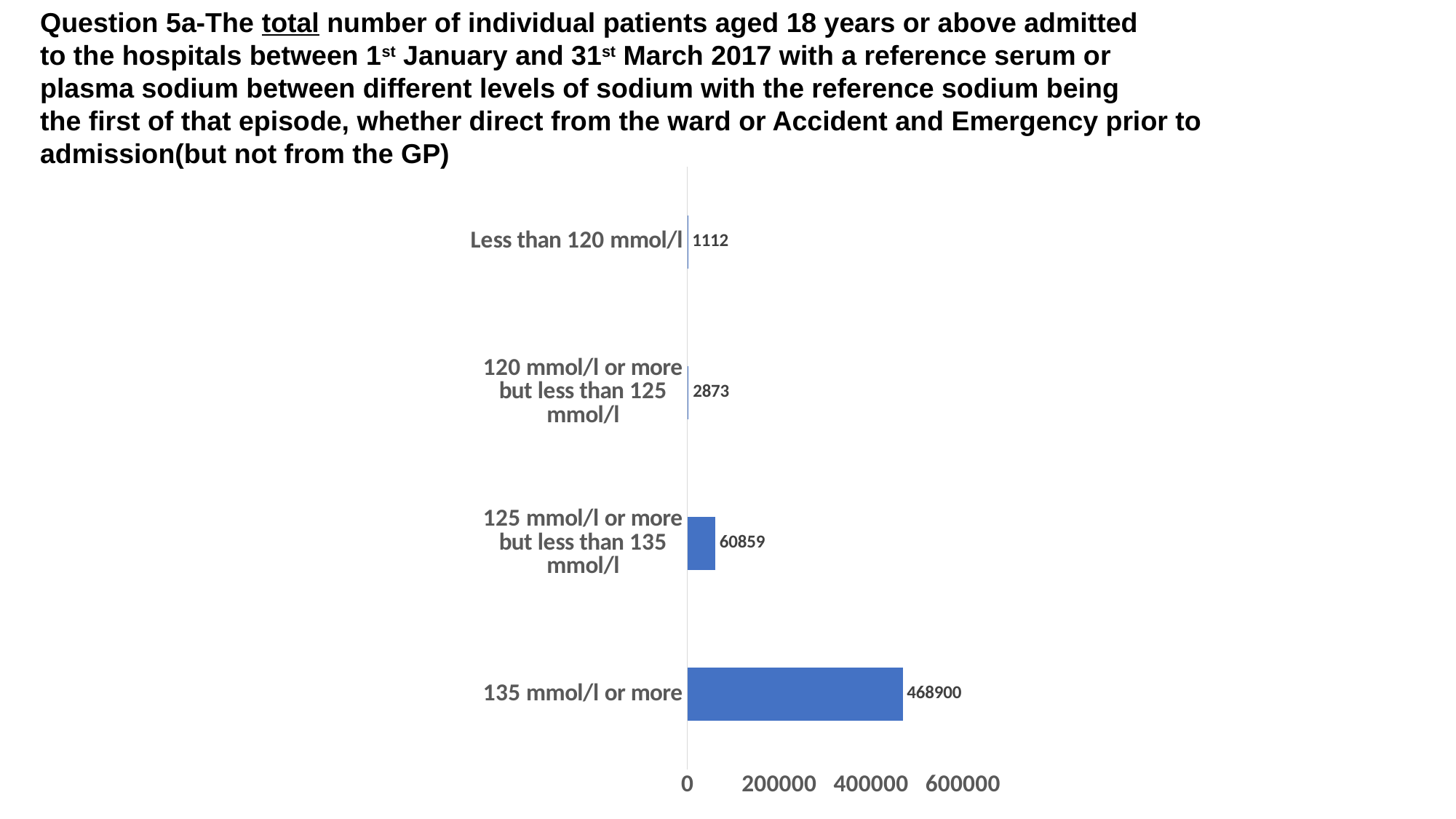
What is the value for the 'Less than 120 mmol/l' category? 1112 What is the difference between the values for '120 mmol/l or more but less than 125 mmol/l' and 'Less than 120 mmol/l'? 1761 What is the value for the '120 mmol/l or more but less than 125 mmol/l' category? 2873 How many categories are shown in the chart? 4 Which category has the lowest value? Less than 120 mmol/l Which is larger: the value for '125 mmol/l or more but less than 135 mmol/l' or the value for '120 mmol/l or more but less than 125 mmol/l'? 125 mmol/l or more but less than 135 mmol/l What is the value for the '125 mmol/l or more but less than 135 mmol/l' category? 60859 What is the difference between the values for '135 mmol/l or more' and '125 mmol/l or more but less than 135 mmol/l'? 408041 Which category has the highest value? 135 mmol/l or more Is the value for '135 mmol/l or more' greater or less than 400000? greater What is the value for the '135 mmol/l or more' category? 468900 What kind of chart is shown on the slide? bar chart